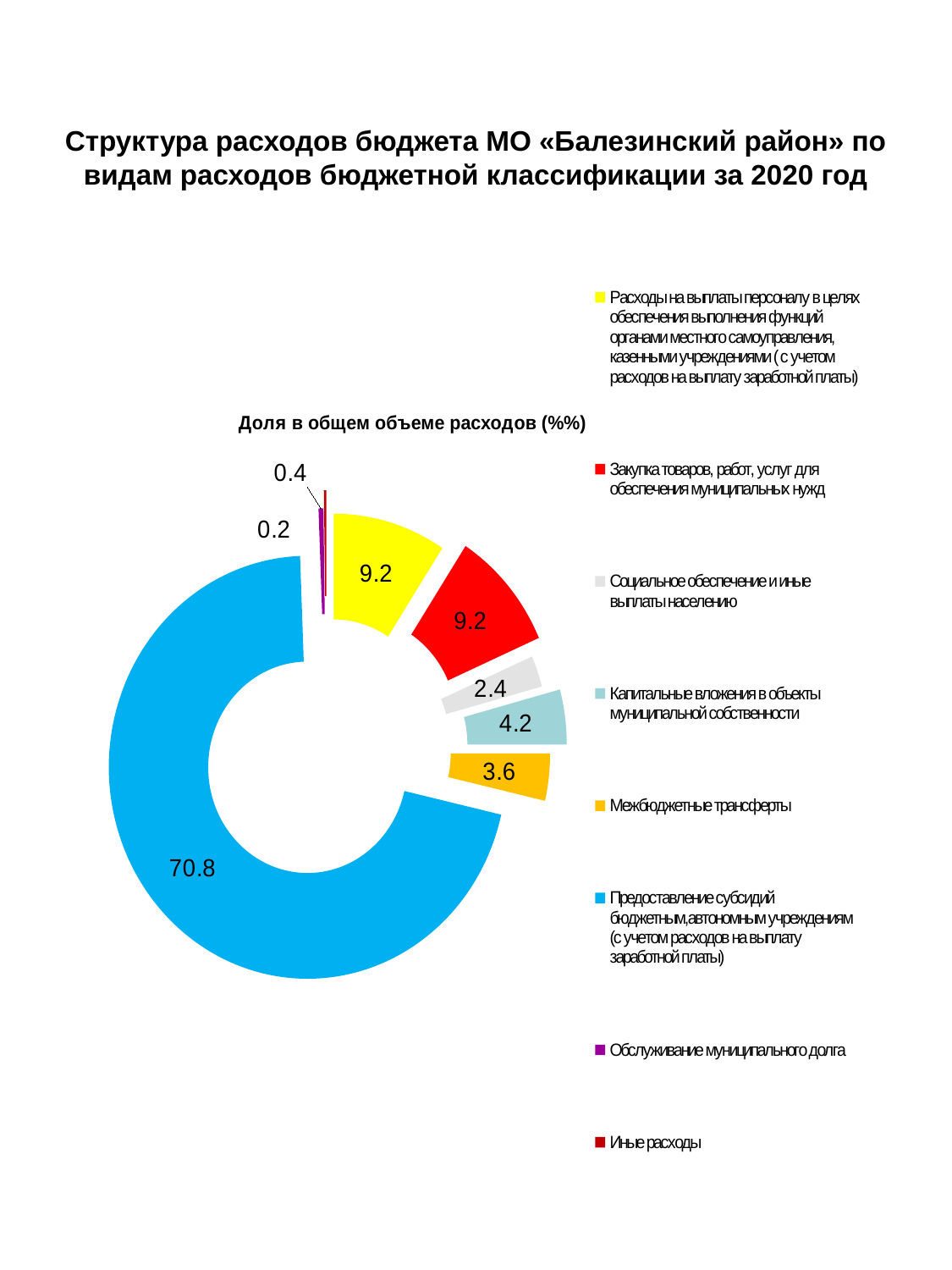
What is the chart's title? Доля в общем объеме расходов (%%) What is the value for «Предоставление субсидий бюджетным, автономным учреждениям»? 70.8 What is the value for «Закупка товаров, работ, услуг для обеспечения муниципальных нужд»? 9.2 What is the value for «Социальное обеспечение и иные выплаты населению»? 2.4 What is the value for «Капитальные вложения в объекты муниципальной собственности»? 4.2 Which is larger: «Межбюджетные трансферты» or «Капитальные вложения в объекты муниципальной собственности»? Капитальные вложения в объекты муниципальной собственности What kind of chart is shown on the slide? Doughnut (pie) chart How many categories does the legend list? 8 Which category has the largest share? Предоставление субсидий бюджетным, автономным учреждениям What is the difference between the values for «Капитальные вложения в объекты муниципальной собственности» and «Социальное обеспечение и иные выплаты населению»? 1.8 What is the difference between the values for «Предоставление субсидий бюджетным, автономным учреждениям» and «Закупка товаров, работ, услуг для обеспечения муниципальных нужд»? 61.6 What is the value for «Межбюджетные трансферты»? 3.6